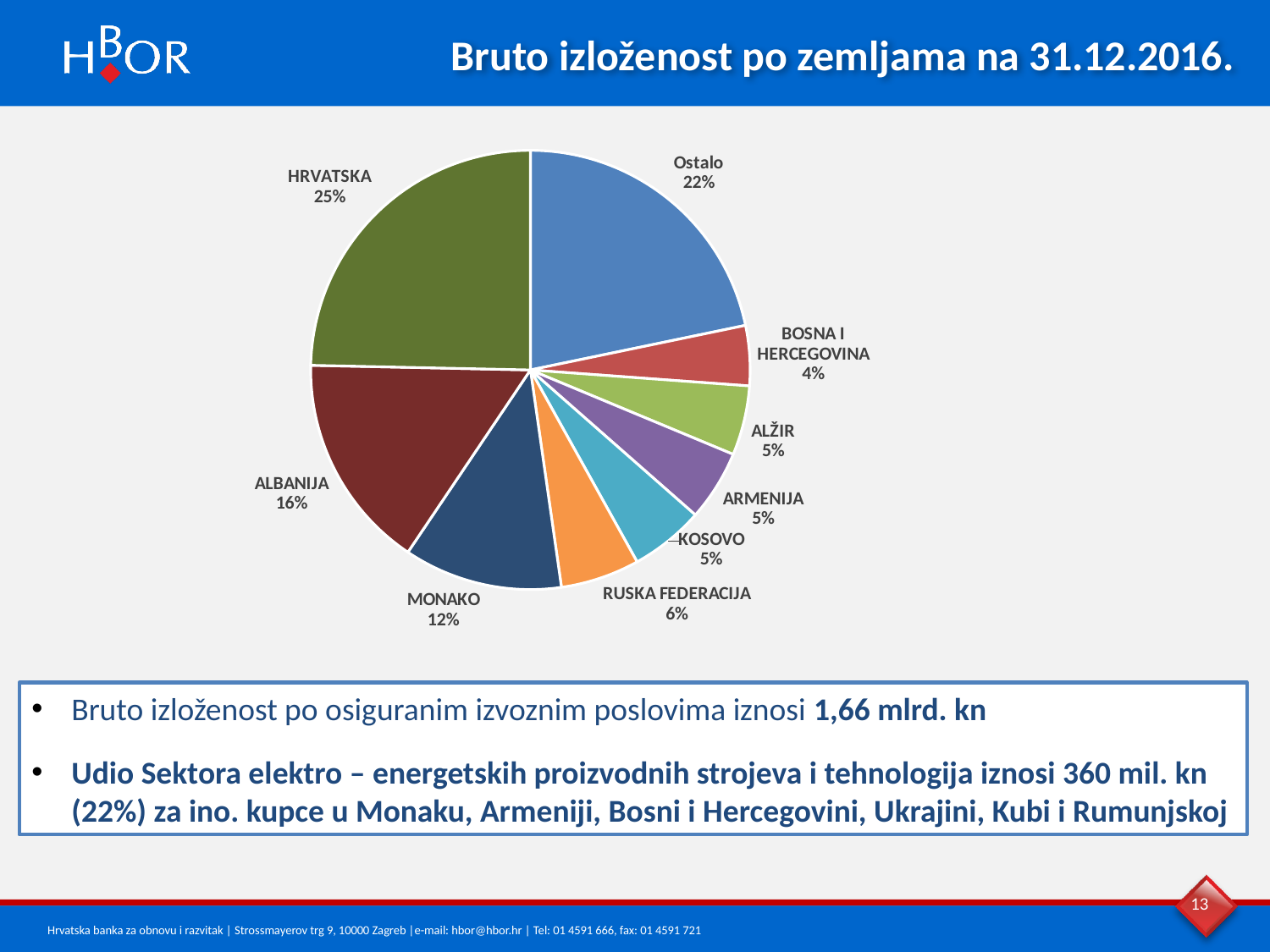
What type of chart is shown on the slide? pie chart What share of the pie does HRVATSKA have? 25% What is the value shown for BOSNA I HERCEGOVINA? 4% What is the value shown for RUSKA FEDERACIJA? 6% What is the value shown for MONAKO? 12% What is the value shown for ALBANIJA? 16% Which is larger, the share for Ostalo or the share for MONAKO? Ostalo How many slices does the pie chart have? 9 Which category has the largest share of the pie? HRVATSKA What is the difference in percentage points between HRVATSKA and ALBANIJA? 9 What is the title of the chart slide? Bruto izloženost po zemljama na 31.12.2016. Which category has the smallest share of the pie? BOSNA I HERCEGOVINA